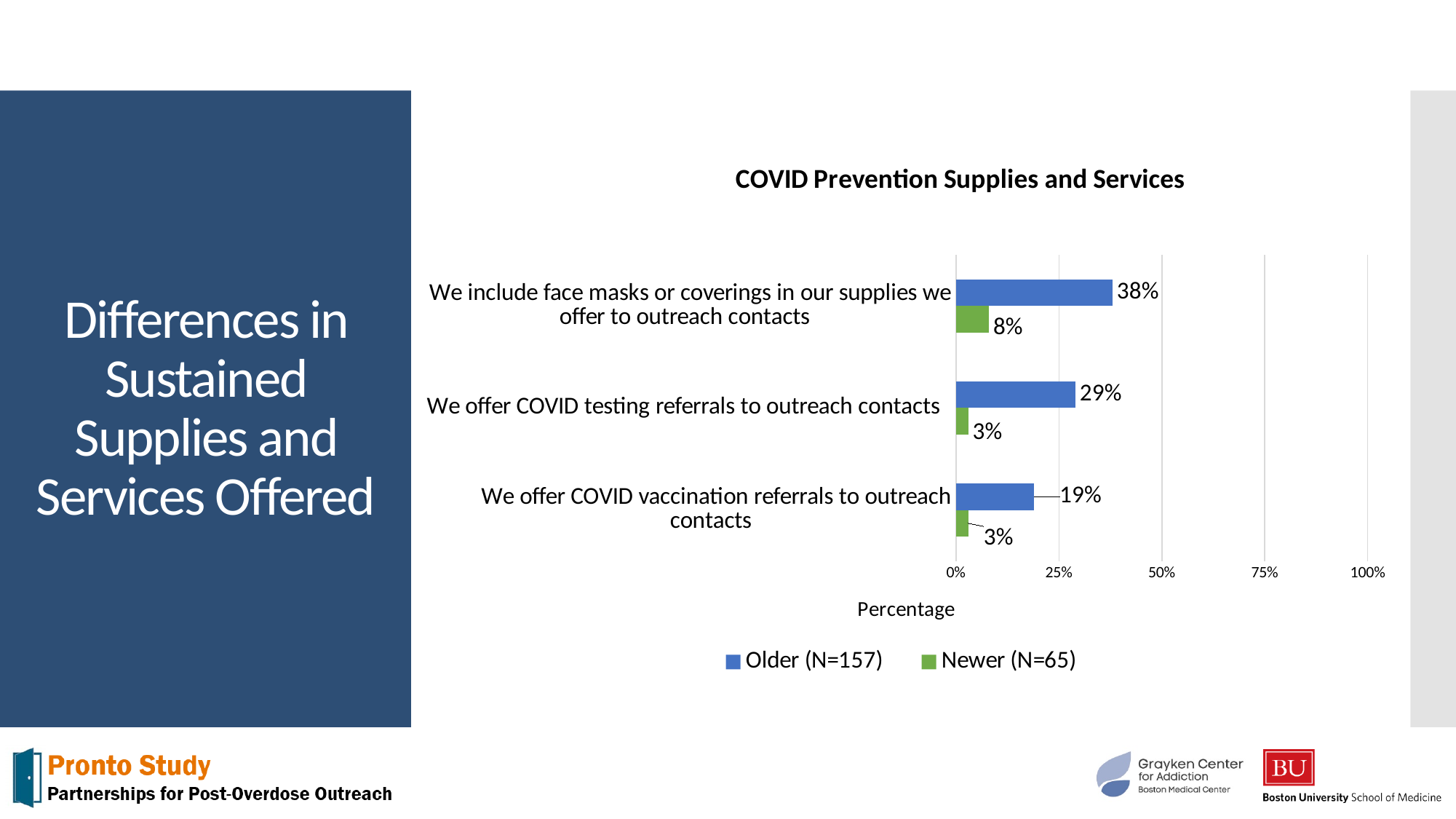
What kind of chart is shown on the slide? Bar chart What is the value for Older (N=157) for 'We include face masks or coverings in our supplies we offer to outreach contacts'? 38% How many series does the legend list? 2 What is the difference between the Older (N=157) and Newer (N=65) values for 'We offer COVID testing referrals to outreach contacts'? 26% What is the value for Newer (N=65) for 'We offer COVID testing referrals to outreach contacts'? 3% Which category has the highest value for Older (N=157)? We include face masks or coverings in our supplies we offer to outreach contacts How many categories are shown on the chart? 3 What is the value for Older (N=157) for 'We offer COVID vaccination referrals to outreach contacts'? 19% Which category has the lowest value for Older (N=157)? We offer COVID vaccination referrals to outreach contacts Which is larger for 'We offer COVID vaccination referrals to outreach contacts': the Older (N=157) value or the Newer (N=65) value? Older (N=157) Is the Older (N=157) value for 'We offer COVID testing referrals to outreach contacts' greater or less than 25%? greater What is the value for Newer (N=65) for 'We include face masks or coverings in our supplies we offer to outreach contacts'? 8%